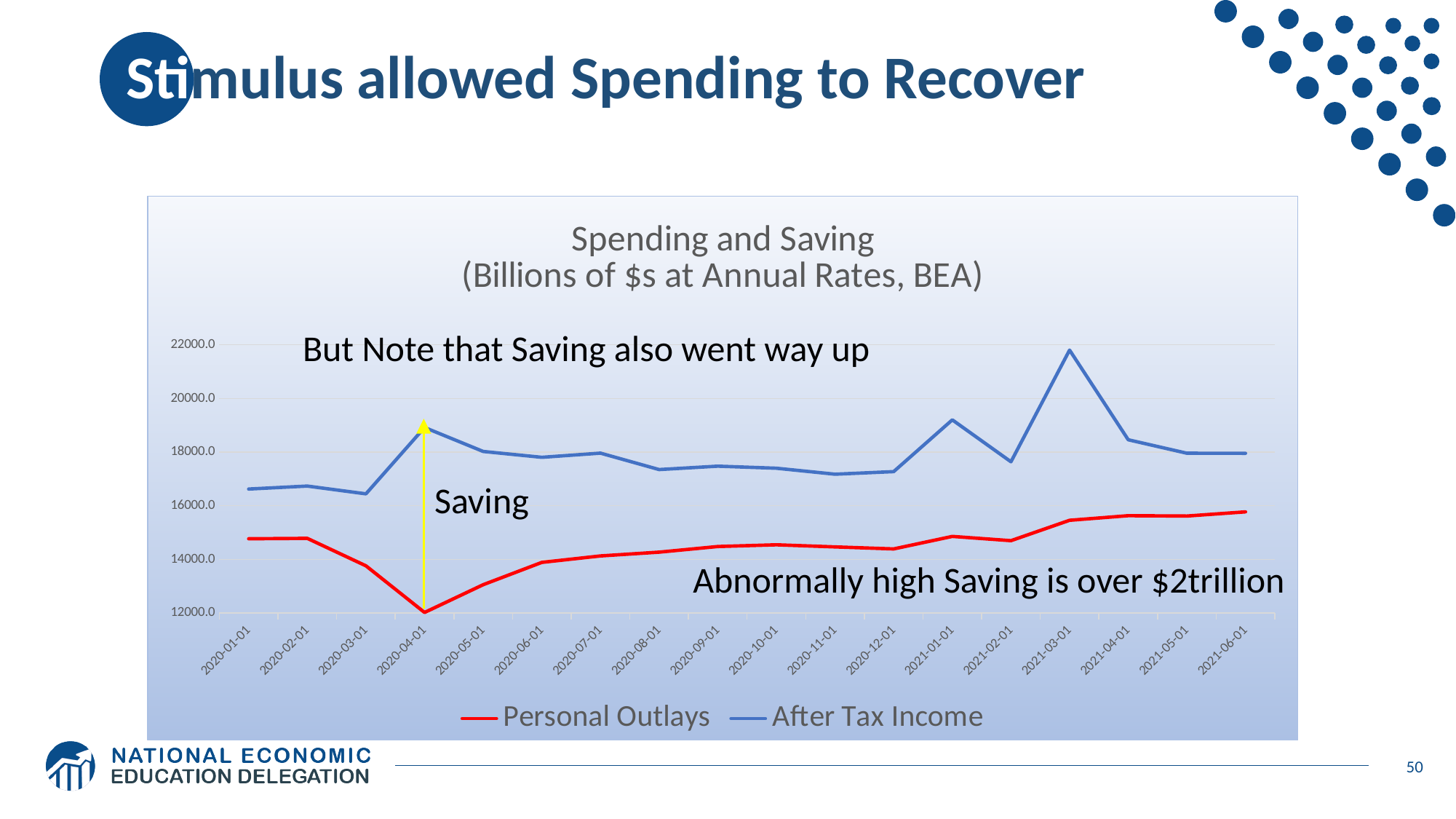
Is the value of After Tax Income at 2020-04-01 greater or less than 20000.0? less What is the title of the chart? Spending and Saving (Billions of $s at Annual Rates, BEA) Is the value of After Tax Income at 2021-03-01 greater or less than 20000.0? greater How many series does the chart's legend list? 2 On which date does After Tax Income reach its highest value? 2021-03-01 On which date do Personal Outlays reach their lowest value? 2020-04-01 What kind of chart is shown on the slide? line chart How many dates are shown along the x axis of the chart? 18 At 2020-04-01, which series has the larger value, Personal Outlays or After Tax Income? After Tax Income Do Personal Outlays generally rise or fall from 2020-04-01 to 2021-06-01? rise Is the value of Personal Outlays at 2020-01-01 greater or less than 16000.0? less Which series is drawn in red in the chart? Personal Outlays